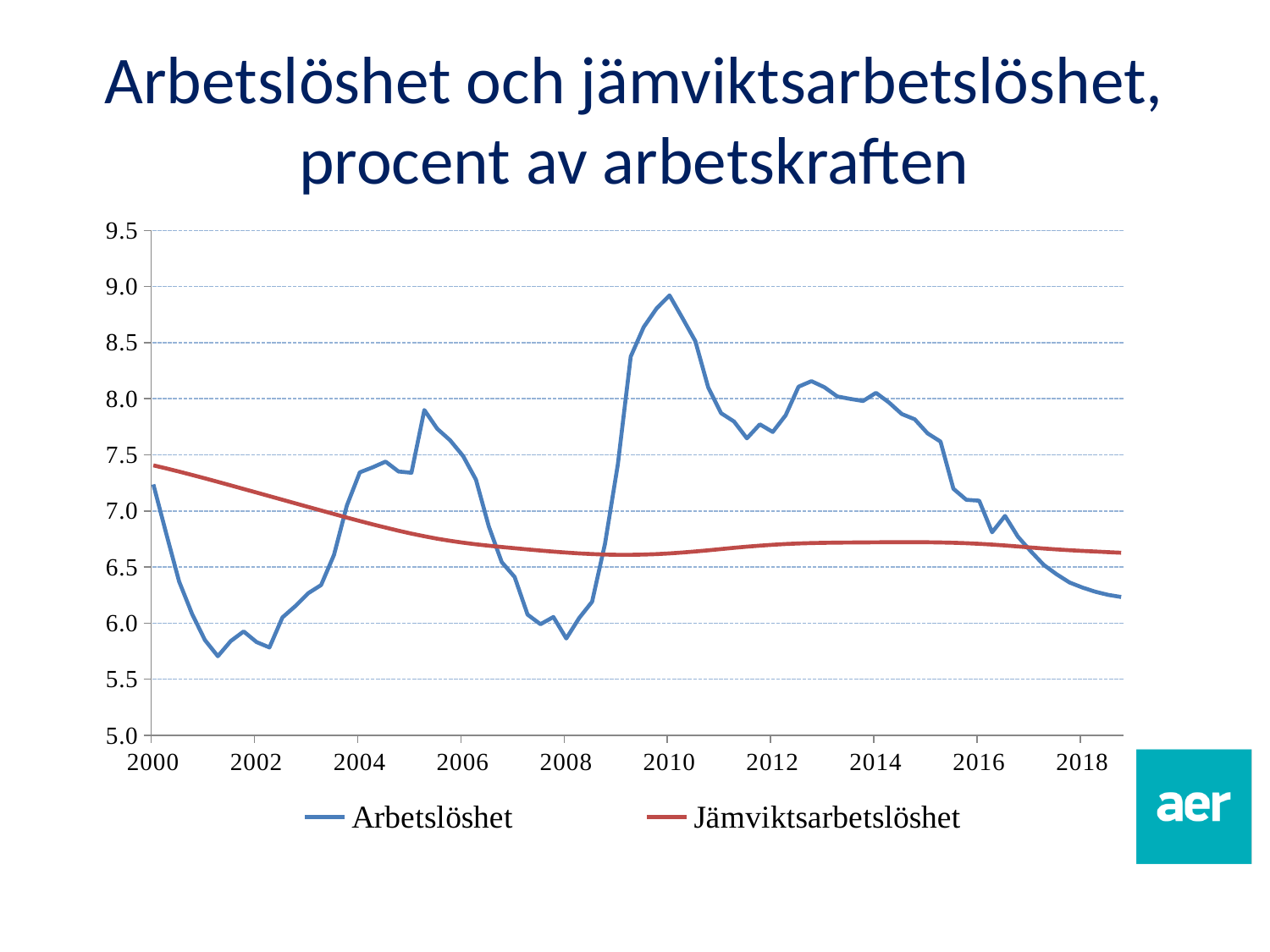
Is the value for Arbetslöshet in 2010 greater or less than 8.5? greater Around which year does the Arbetslöshet line reach its highest point? 2010 Which colour is the Jämviktsarbetslöshet line? Red Does the Jämviktsarbetslöshet line rise or fall between 2000 and 2008? Fall In 2002, which series has the higher value, Arbetslöshet or Jämviktsarbetslöshet? Jämviktsarbetslöshet Is the value for Arbetslöshet in 2008 greater or less than 6.5? less What are the two series named in the legend? Arbetslöshet and Jämviktsarbetslöshet Is the value for Jämviktsarbetslöshet in 2018 greater or less than 7.0? less How many series does the legend list? 2 In 2010, which series has the higher value, Arbetslöshet or Jämviktsarbetslöshet? Arbetslöshet What kind of chart is shown on the slide? Line chart